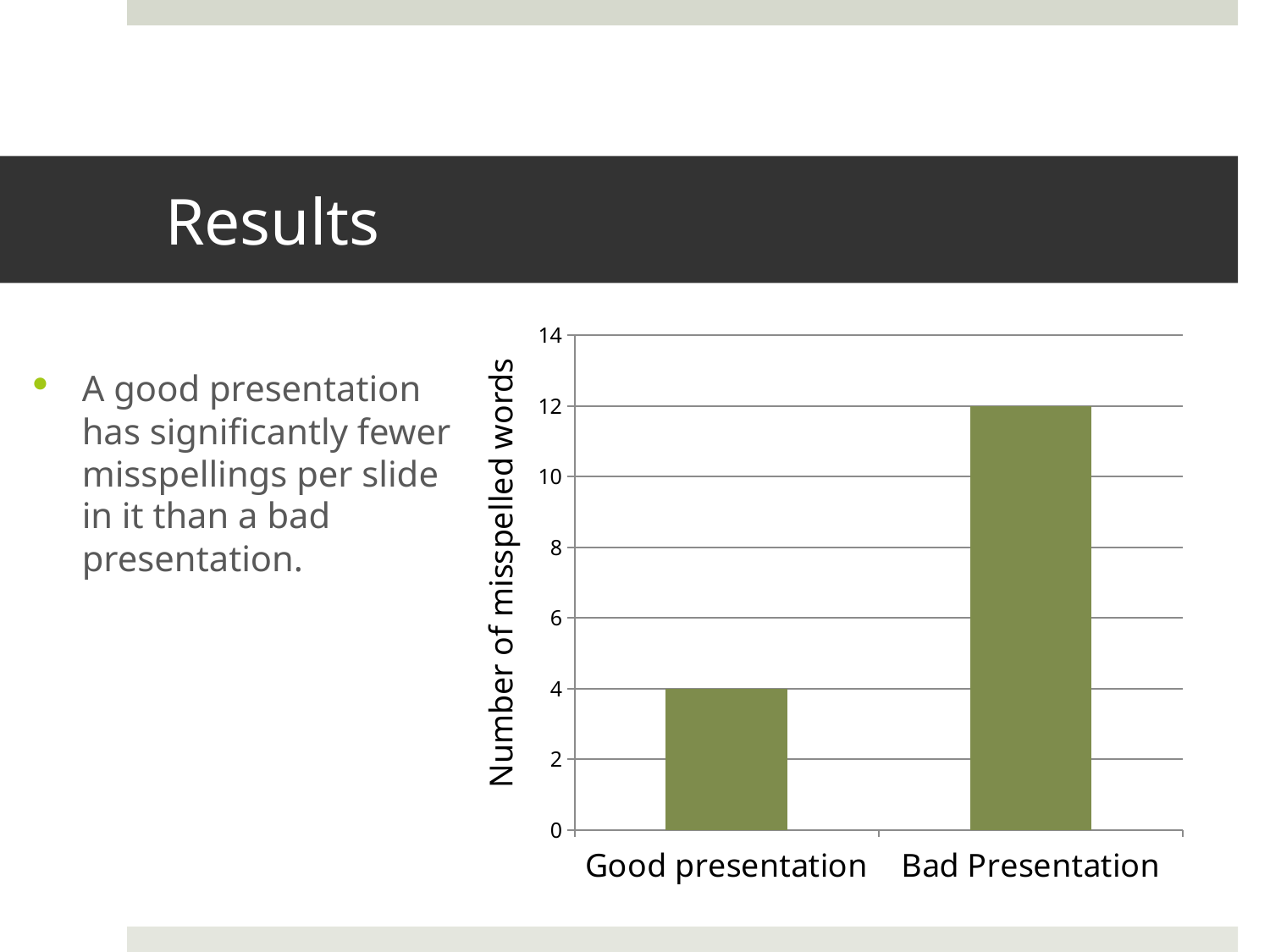
Which has more misspelled words, Good presentation or Bad Presentation? Bad Presentation What kind of chart is shown on the slide? bar chart What is the highest value shown on the vertical axis of the chart? 14 What is the number of misspelled words for Bad Presentation? 12 Which category has the highest number of misspelled words? Bad Presentation Is the value for Good presentation greater or less than 6? less Is the value for Bad Presentation greater or less than 10? greater Which category has the lowest number of misspelled words? Good presentation What is the difference in the number of misspelled words between Bad Presentation and Good presentation? 8 What is the label on the vertical axis of the chart? Number of misspelled words How many categories are plotted on the chart? 2 What is the number of misspelled words for Good presentation? 4